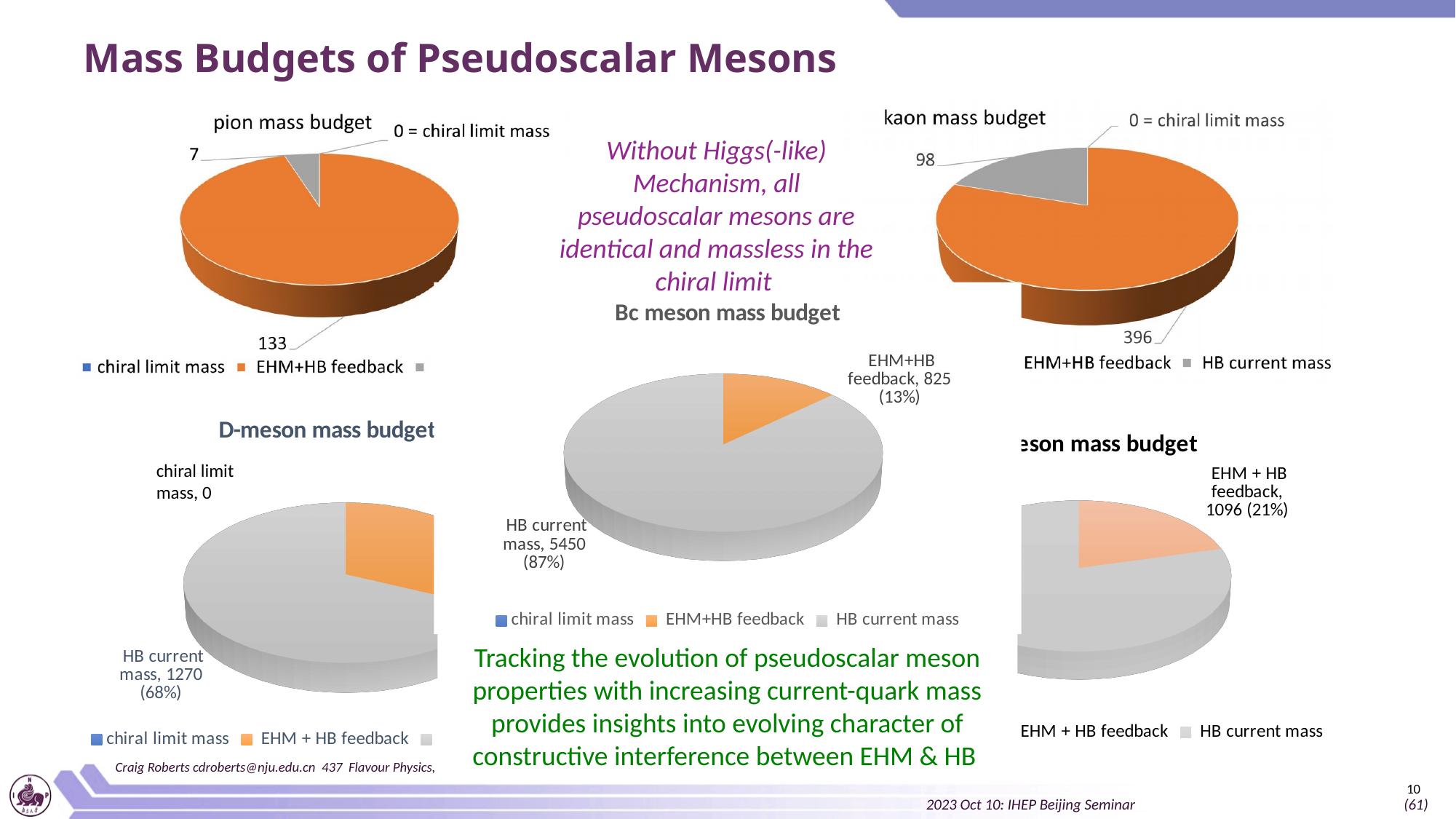
In the kaon mass budget chart, what is the value of the EHM+HB feedback slice? 396 In the Bc meson mass budget chart, what is the value of HB current mass? 5450 What kind of chart is the pion mass budget chart? Pie chart In the kaon mass budget chart, what is the difference between the EHM+HB feedback value and the HB current mass value? 298 In the D-meson mass budget chart, what share of the pie is HB current mass? 68% In the D-meson mass budget chart, what is the value of chiral limit mass? 0 In the bottom-right mass budget chart, what is the value of EHM + HB feedback? 1096 In the pion mass budget chart, what is the value of the small grey slice? 7 In the pion mass budget chart, what is the value of the EHM+HB feedback slice? 133 In the Bc meson mass budget chart, which is larger, HB current mass or EHM+HB feedback? HB current mass In the Bc meson mass budget chart, what share of the pie is EHM+HB feedback? 13% In the kaon mass budget chart, what is the value of the HB current mass slice? 98